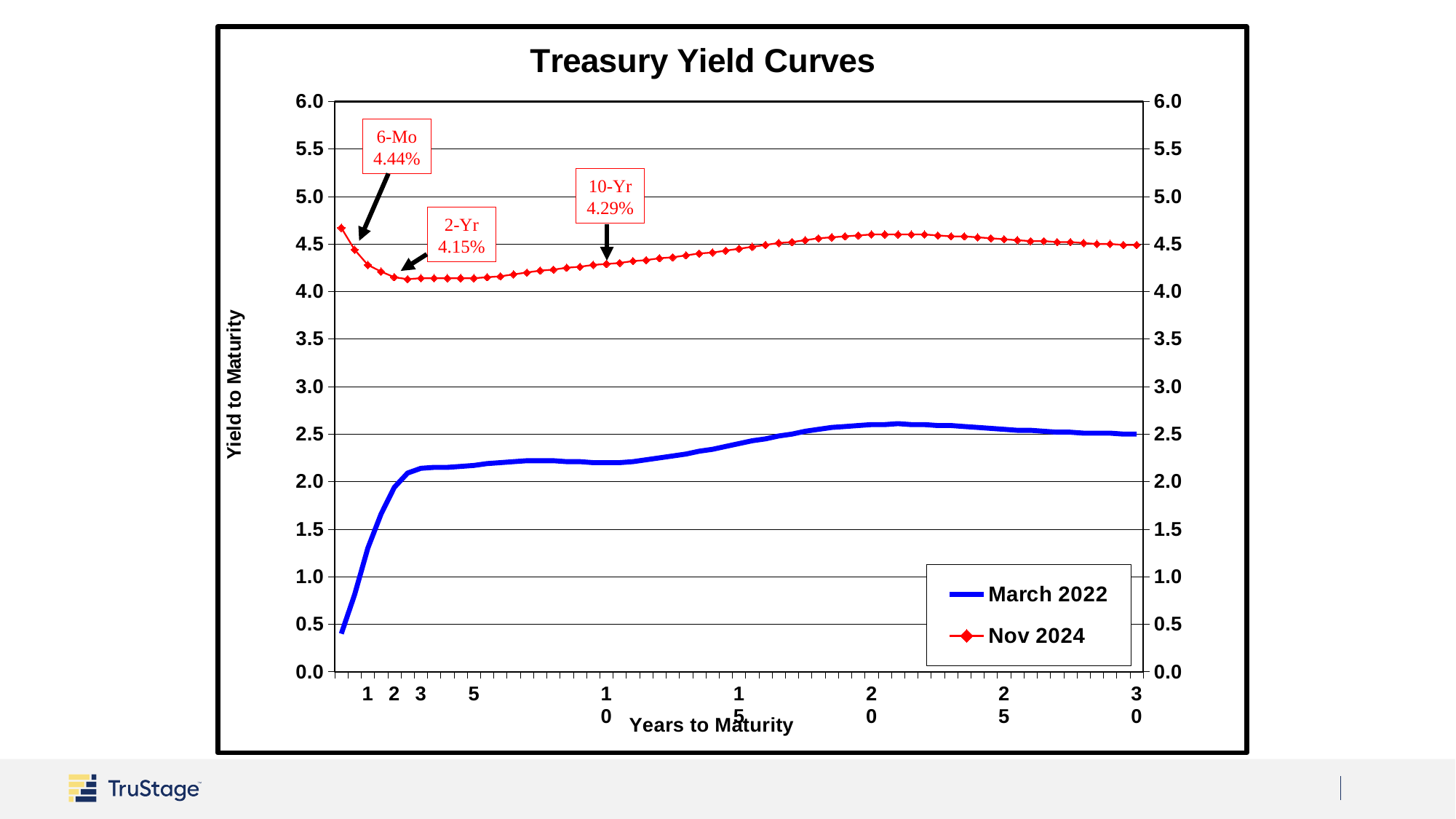
What is the title of the chart? Treasury Yield Curves What is the 10-year yield labelled on the Nov 2024 curve? 4.29% What type of chart is shown on the slide? Line chart What is the 6-month yield labelled on the Nov 2024 curve? 4.44% What is the 2-year yield labelled on the Nov 2024 curve? 4.15% At 10 years to maturity, which series has the higher yield, March 2022 or Nov 2024? Nov 2024 Of the three labelled points on the Nov 2024 curve (6-Mo, 2-Yr, 10-Yr), which has the lowest yield? 2-Yr How many series does the legend list? 2 What is the difference between the labelled 6-month yield and the labelled 2-year yield on the Nov 2024 curve? 0.29% Is the March 2022 yield at 30 years to maturity greater or less than 3.0? less Is the Nov 2024 yield at 30 years to maturity greater or less than 4.0? greater Does the March 2022 curve rise or fall between the shortest maturity and 5 years to maturity? rise